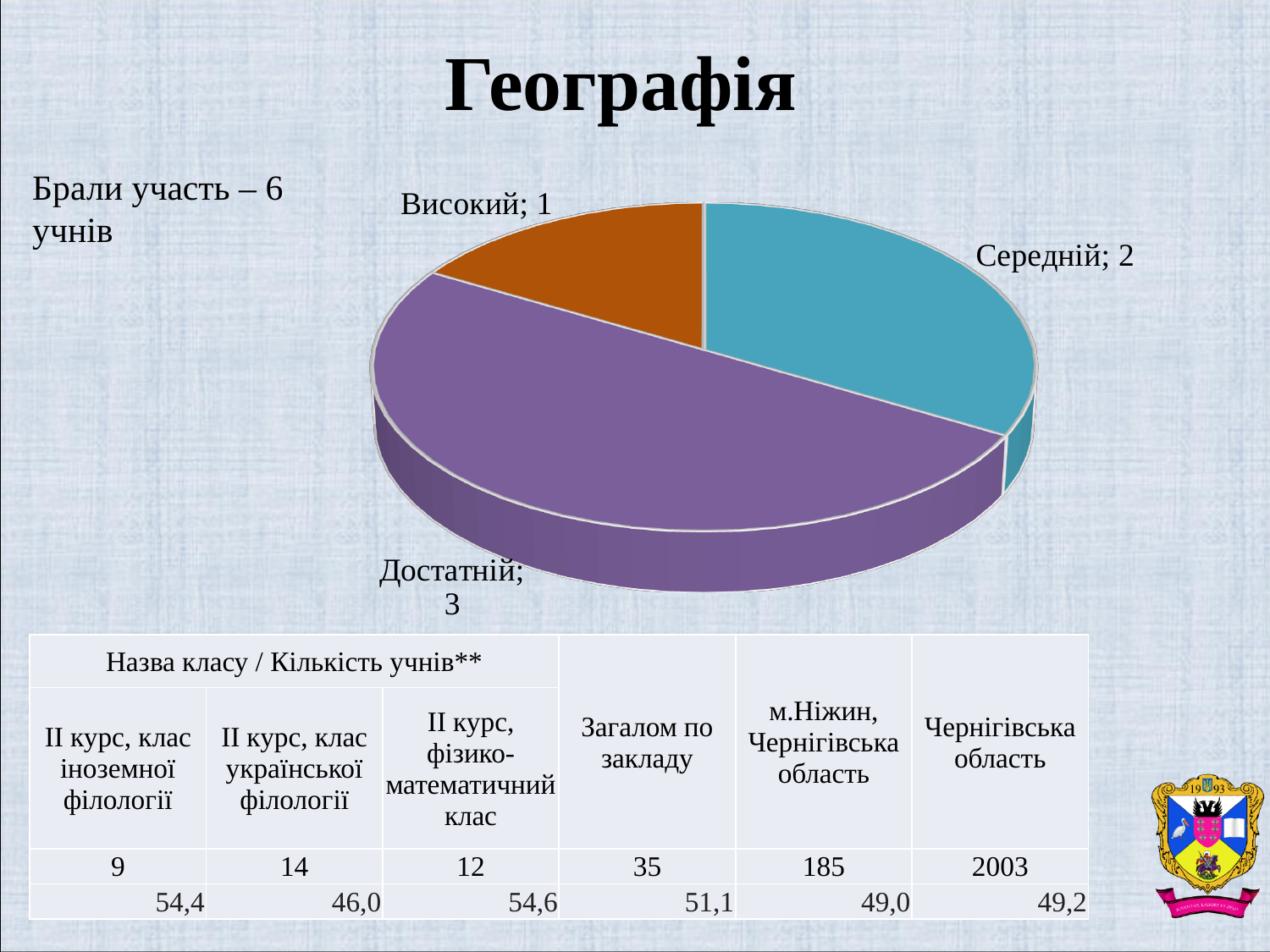
What is the value for Середній in the pie chart? 2 What kind of chart is shown on the slide? pie chart What share of the pie does the Достатній slice represent? 50% Which category has the largest slice in the pie chart? Достатній What is the difference between the values for Середній and Високий? 1 How many slices does the pie chart have? 3 What is the title of the slide containing the pie chart? Географія What is the value for Високий in the pie chart? 1 What is the difference between the values for Достатній and Високий? 2 What is the value for Достатній in the pie chart? 3 Which is larger, the value for Середній or the value for Високий? Середній Which category has the smallest slice in the pie chart? Високий